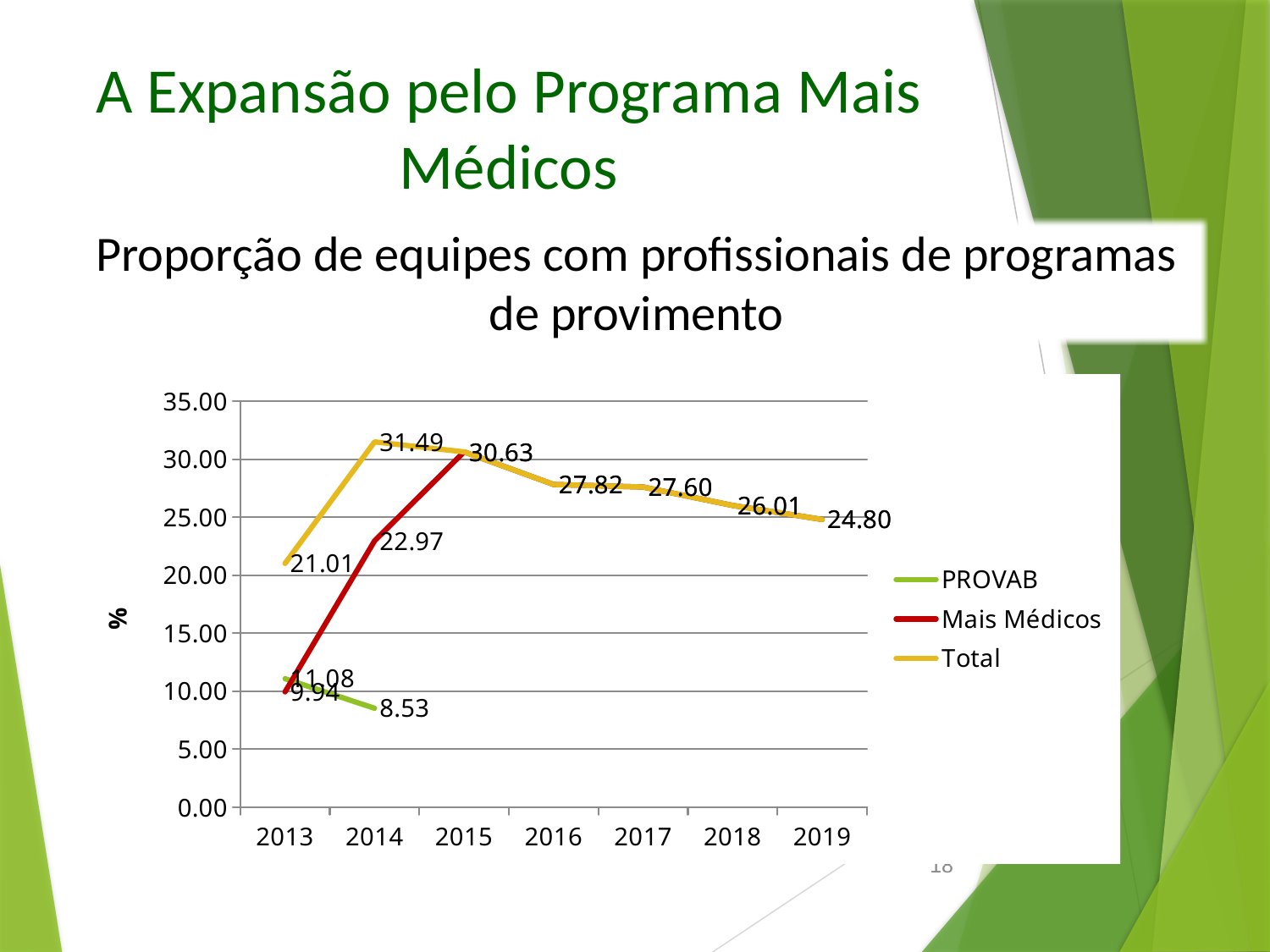
How many years are shown on the x axis? 7 What is the value of the PROVAB series in 2014? 8.53 What is the difference between the Total value in 2014 and in 2019? 6.69 How many series does the legend list? 3 What is the value of the Total series in 2019? 24.80 Does the Total series rise or fall from 2014 to 2019? fall What kind of chart is shown on the slide? line chart What is the value of the Total series in 2014? 31.49 In which year does the Total series reach its highest value? 2014 In 2013, which series has the larger value, PROVAB or Mais Médicos? PROVAB What is the value of the Mais Médicos series in 2014? 22.97 What is the value of the Total series in 2013? 21.01